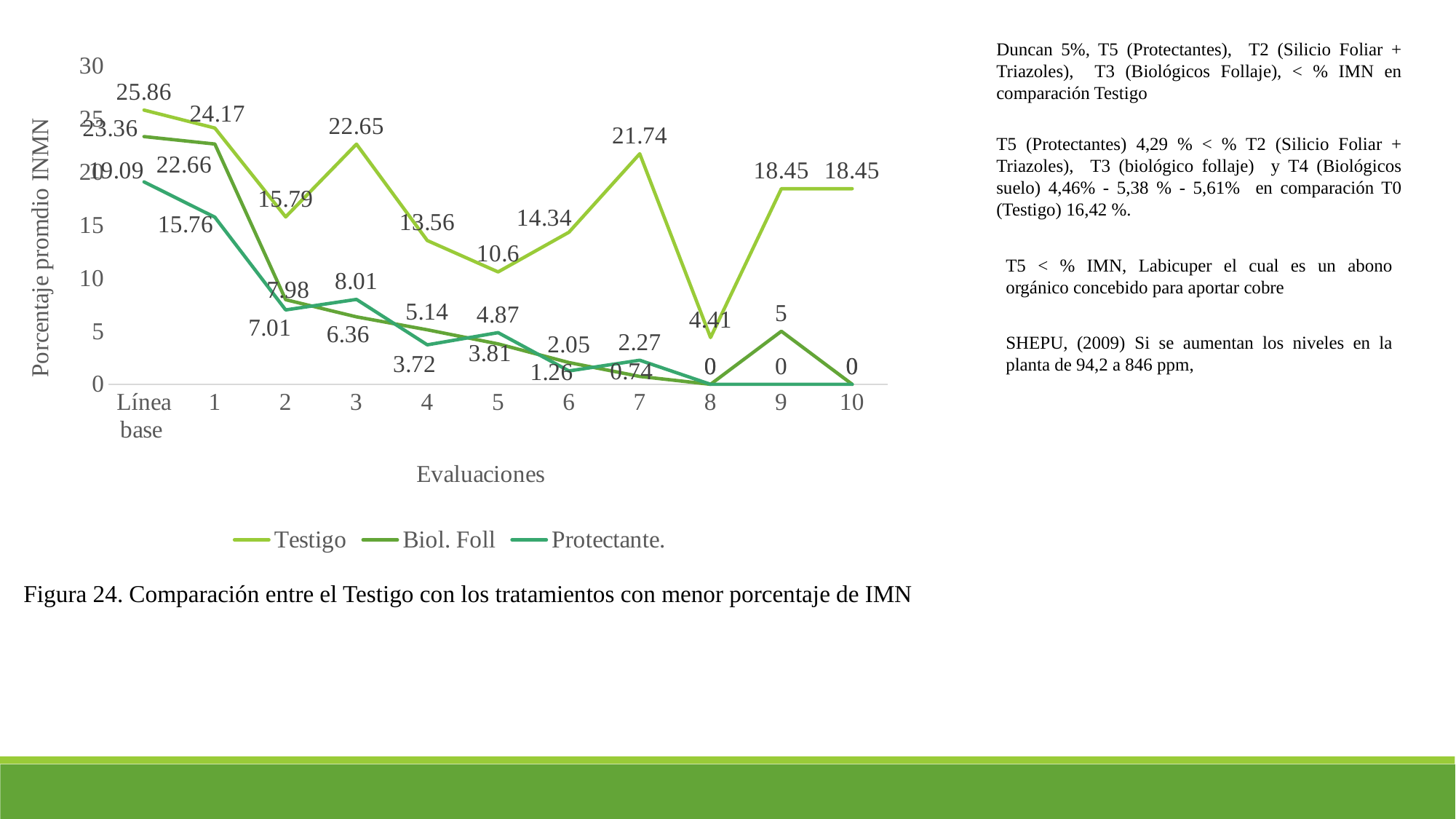
What is the value for Testigo at evaluation 8? 4.41 How many evaluation points are plotted along the x axis? 11 How many series does the legend list? 3 What is the value for Biol. Foll at evaluation 9? 5 What is the value for Testigo at evaluation 7? 21.74 What kind of chart is shown on the slide? line chart At evaluation 5, which series has the larger value, Protectante. or Biol. Foll? Protectante. What is the value for Protectante. at evaluation 3? 8.01 At which x-axis point does the Testigo series reach its highest value? Línea base What is the difference between Testigo and Biol. Foll at evaluation 3? 16.29 What is the title of the y axis? Porcentaje promdio INMN At which evaluation does the Testigo series reach its lowest value? 8